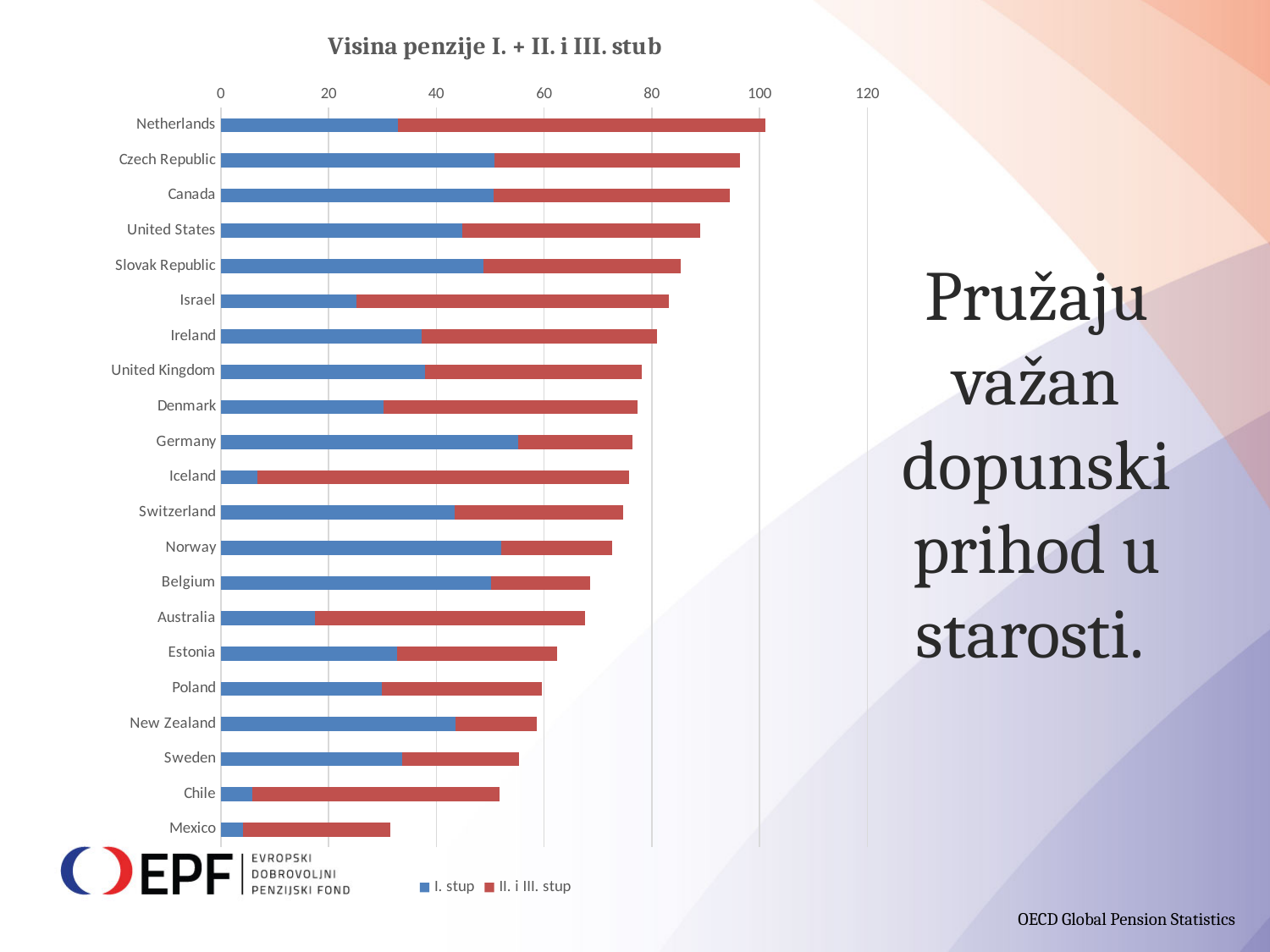
Which country has the longest total bar? Netherlands Which series is shown in red in the legend? II. i III. stup Is the I. stup value for Germany greater or less than 40? greater Which country has the shortest total bar? Mexico What is the title of the chart? Visina penzije I. + II. i III. stub Do the total bar lengths increase or decrease going from the top of the chart to the bottom? decrease Is the I. stup value for Iceland greater or less than 20? less What kind of chart is shown on the slide? Stacked bar chart Is the total bar for Mexico greater or less than 40? less How many countries are listed on the chart? 21 Which country has a longer total bar, Canada or Australia? Canada How many series does the legend list? 2